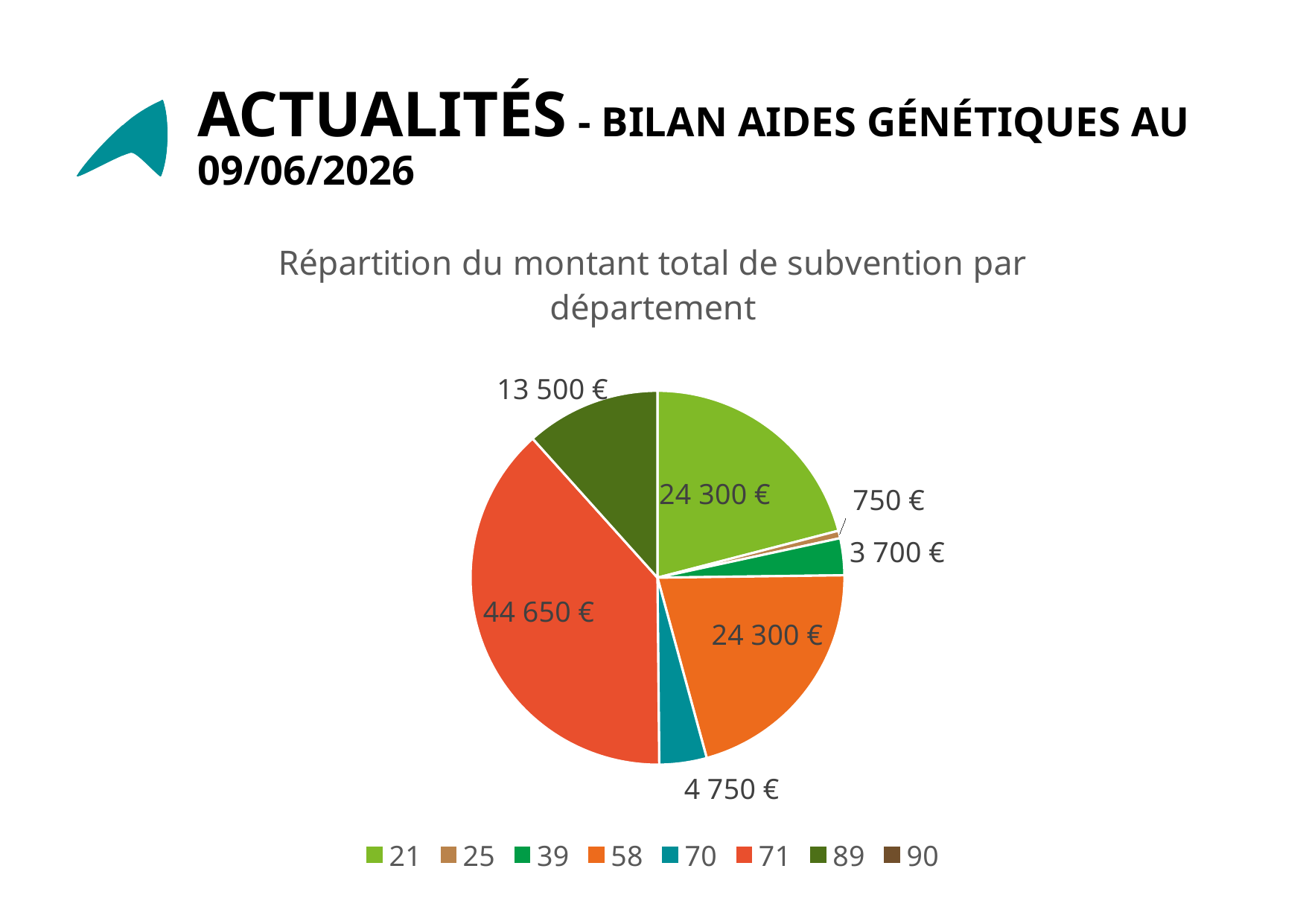
What is the subsidy amount for département 70? 4 750 € What kind of chart is shown on the slide? pie chart What is the subsidy amount for département 39? 3 700 € What is the subsidy amount for département 25? 750 € How many départements does the legend list? 8 What is the subsidy amount for département 89? 13 500 € What is the difference between the amounts for département 58 and département 70? 19 550 € What is the difference between the amounts for département 71 and département 89? 31 150 € Which département has the largest slice of the pie? 71 Which has a larger amount, département 70 or département 39? 70 Which has a larger amount, département 89 or département 58? 58 What is the subsidy amount for département 71? 44 650 €